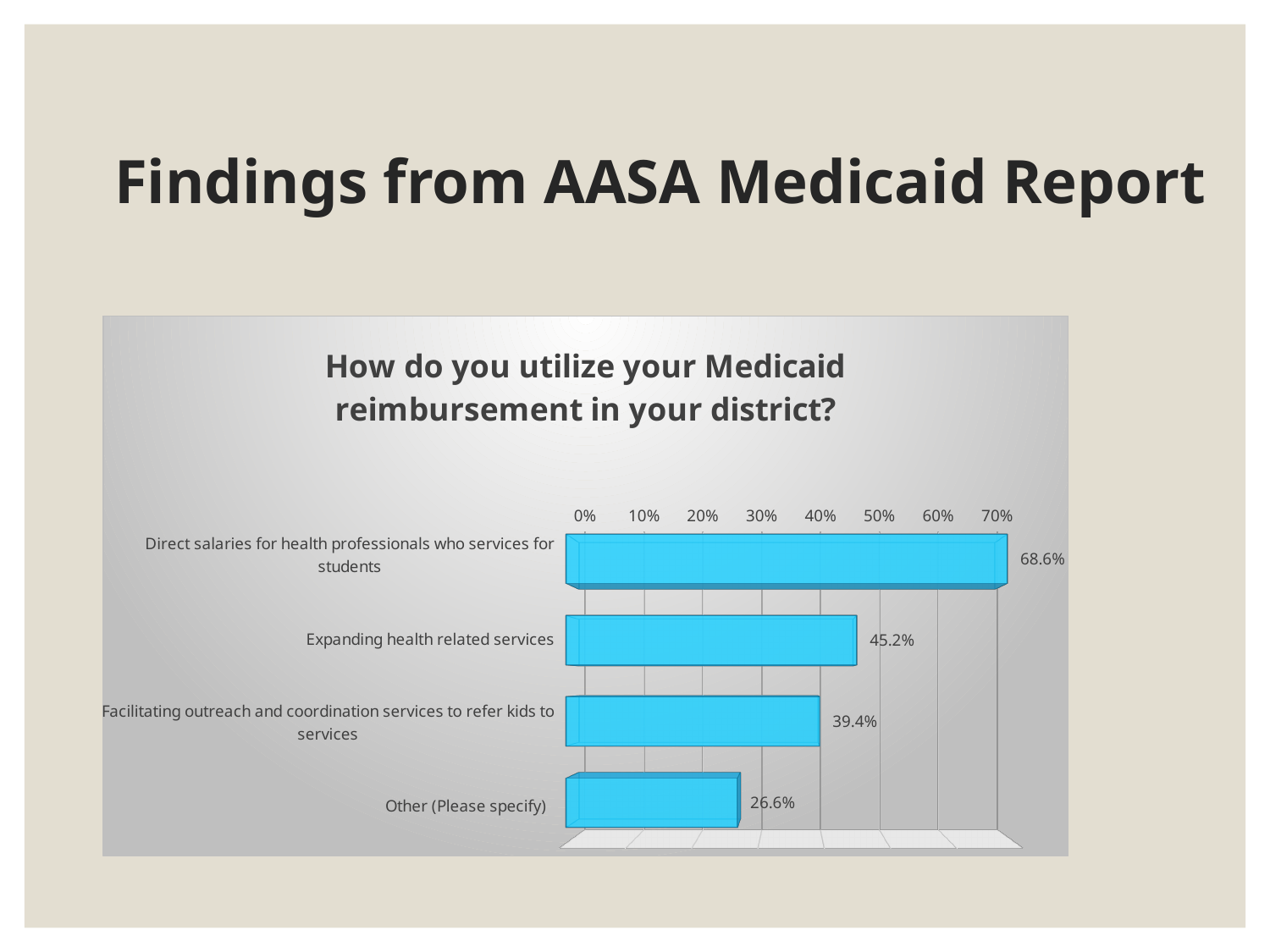
What type of chart is shown on the slide? Bar chart What is the value for 'Facilitating outreach and coordination services to refer kids to services'? 39.4% What is the value for 'Other (Please specify)'? 26.6% Which is larger: the value for 'Expanding health related services' or for 'Facilitating outreach and coordination services to refer kids to services'? Expanding health related services Is the value for 'Facilitating outreach and coordination services to refer kids to services' greater or less than 30%? greater What is the title of the chart? How do you utilize your Medicaid reimbursement in your district? Which category has the lowest value? Other (Please specify) Which category has the highest value? Direct salaries for health professionals who services for students How many categories are shown in the chart? 4 What is the difference between the values for 'Expanding health related services' and 'Other (Please specify)'? 18.6% What is the value for 'Expanding health related services'? 45.2% What percentage of respondents use Medicaid reimbursement for direct salaries for health professionals who service students? 68.6%